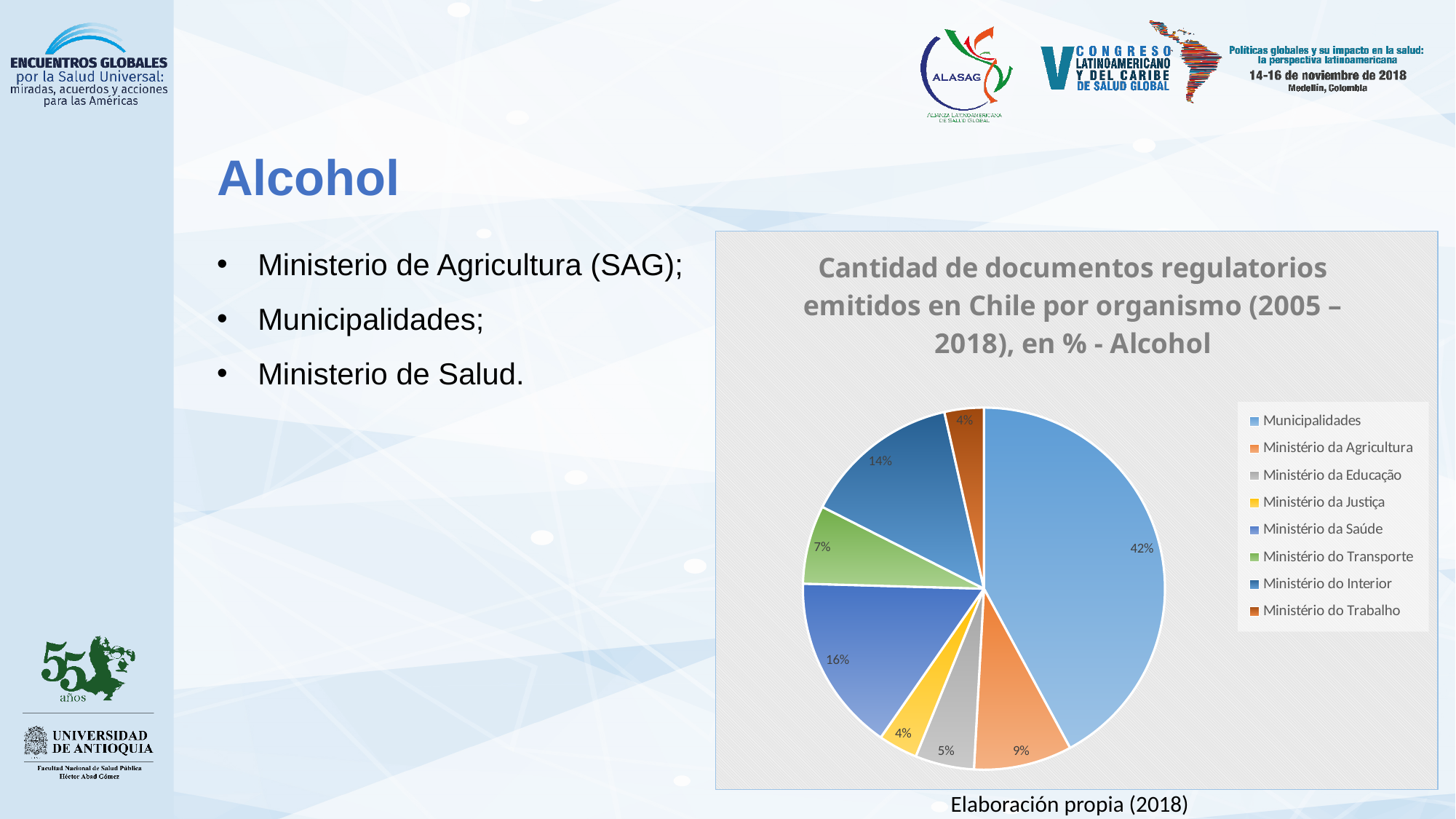
Which category has the largest share of the pie? Municipalidades What colour is the slice for Ministério da Justiça? yellow What share of the pie does Ministério do Interior have? 14% What share of the pie does Municipalidades have? 42% What share of the pie does Ministério da Saúde have? 16% What kind of chart is shown on the slide? pie chart What is the difference between the share for Municipalidades and the share for Ministério da Saúde? 26% Which is larger, the share for Ministério da Saúde or the share for Ministério do Interior? Ministério da Saúde How many categories does the legend of the pie chart list? 8 What is the title of the chart? Cantidad de documentos regulatorios emitidos en Chile por organismo (2005 – 2018), en % - Alcohol What share of the pie does Ministério do Transporte have? 7% What share of the pie does Ministério da Agricultura have? 9%